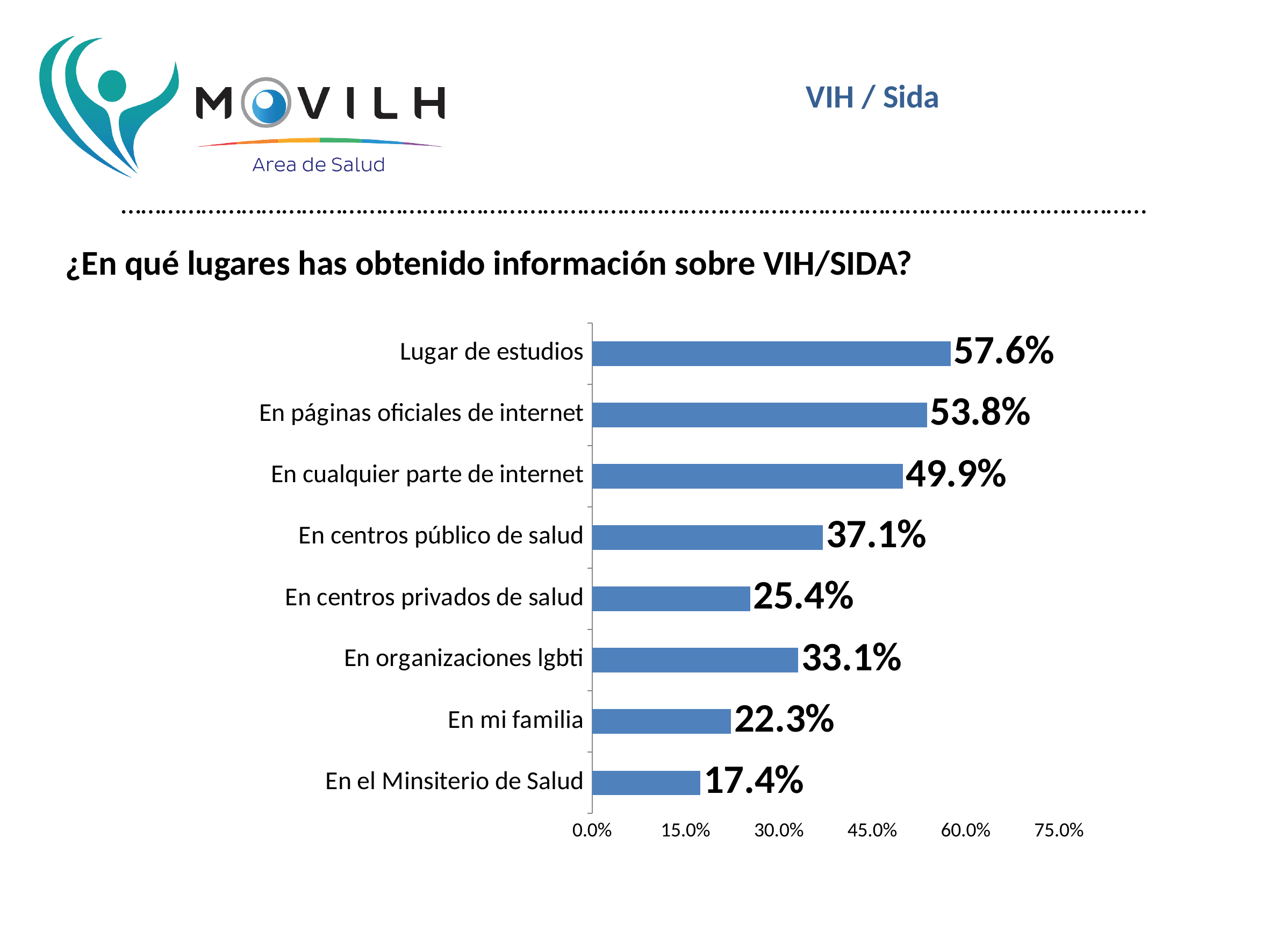
What is the difference between the values for "En centros público de salud" and "En centros privados de salud"? 11.7% What is the difference between the values for "Lugar de estudios" and "En páginas oficiales de internet"? 3.8% What is the value for "Lugar de estudios"? 57.6% How many categories are shown in the chart? 8 Which category has the lowest value? En el Minsiterio de Salud What is the value for "En organizaciones lgbti"? 33.1% What kind of chart is shown on the slide? bar chart Is the value for "En cualquier parte de internet" greater or less than 45.0%? greater Which is larger, the value for "En centros privados de salud" or the value for "En organizaciones lgbti"? En organizaciones lgbti What is the value for "En mi familia"? 22.3% What question does the chart title ask? ¿En qué lugares has obtenido información sobre VIH/SIDA? Which category has the highest value? Lugar de estudios